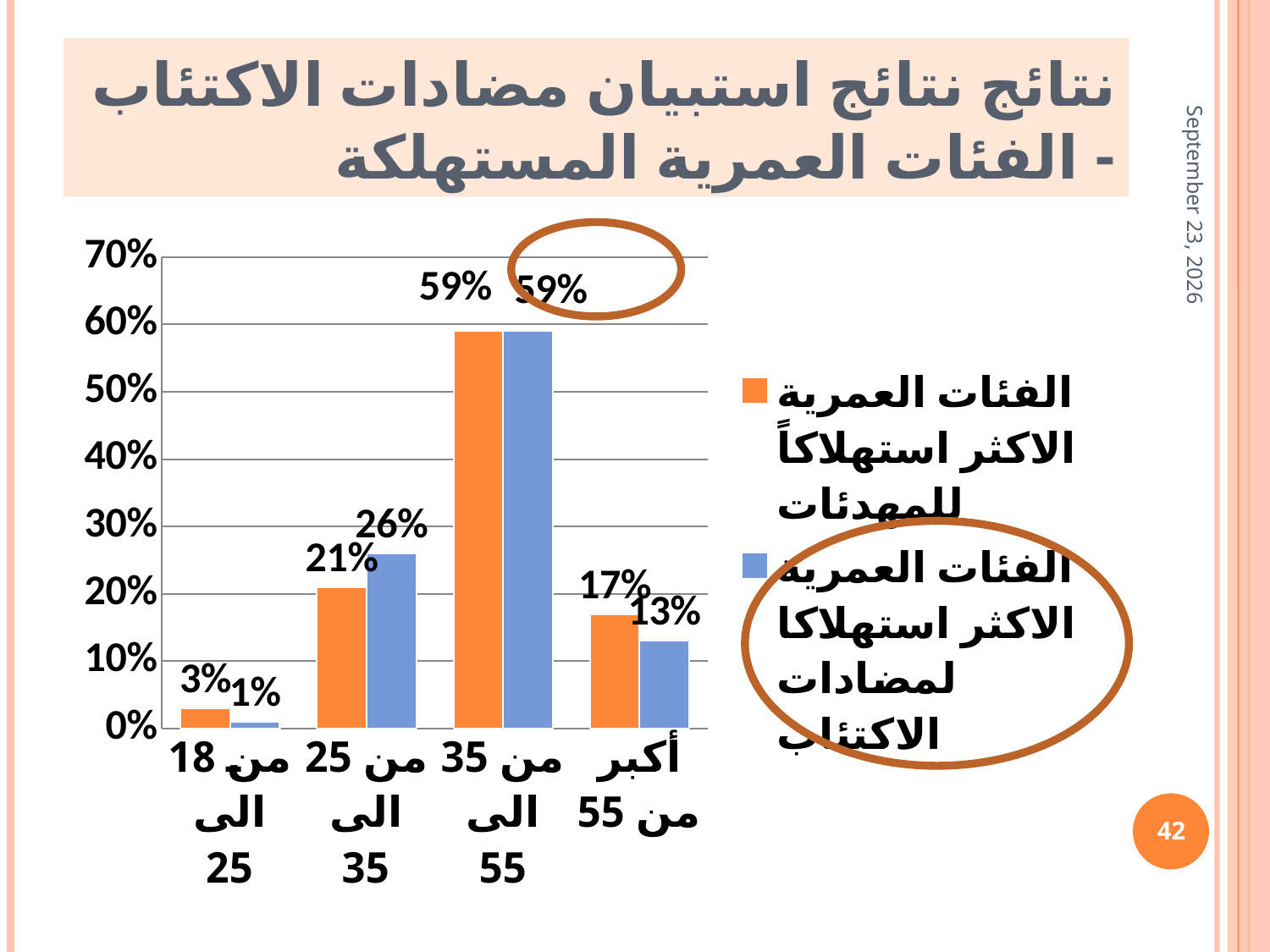
What is the value of the orange series (الفئات العمرية الاكثر استهلاكاً للمهدئات) for the category من 25 الى 35? 21% What is the value of the blue series (الفئات العمرية الاكثر استهلاكا لمضادات الاكتئاب) for the category من 25 الى 35? 26% What kind of chart is shown on the slide? bar chart How many series does the chart's legend list? 2 Which age category has the highest value for the blue series (الفئات العمرية الاكثر استهلاكا لمضادات الاكتئاب)? من 35 الى 55 What is the value of the orange series (الفئات العمرية الاكثر استهلاكاً للمهدئات) for the category من 18 الى 25? 3% What is the difference between the orange and blue values for the category أكبر من 55? 4% How many age categories are shown on the x axis of the chart? 4 For the category من 25 الى 35, which series has the larger value, the orange (المهدئات) or the blue (مضادات الاكتئاب)? blue (مضادات الاكتئاب) Which series in the legend is shown in orange? الفئات العمرية الاكثر استهلاكاً للمهدئات Which age category has the lowest value for the orange series (الفئات العمرية الاكثر استهلاكاً للمهدئات)? من 18 الى 25 What is the value of the blue series (الفئات العمرية الاكثر استهلاكا لمضادات الاكتئاب) for the category أكبر من 55? 13%